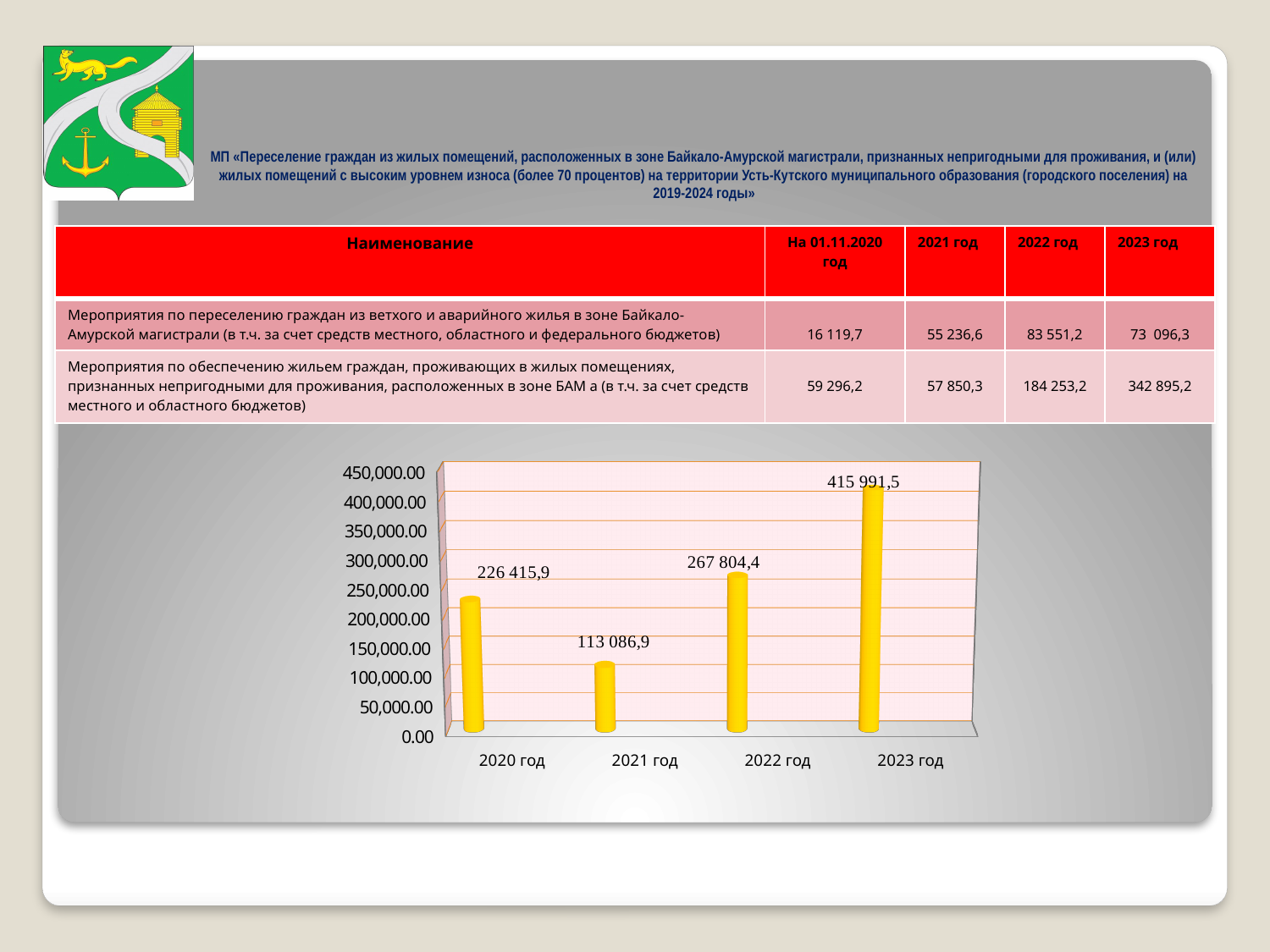
Which is larger, the value for 2020 год or the value for 2022 год? 2022 год What kind of chart is shown on the slide? bar chart What is the value shown for 2020 год? 226 415,9 What is the value shown for 2022 год? 267 804,4 How many years (categories) are shown in the chart? 4 Is the value for 2021 год greater or less than 150,000.00? less What colour are the bars in the chart? yellow What is the value shown for 2023 год? 415 991,5 Which year has the lowest value in the chart? 2021 год What is the difference between the values for 2023 год and 2022 год? 148 187,1 Which year has the highest value in the chart? 2023 год What is the value shown for 2021 год? 113 086,9